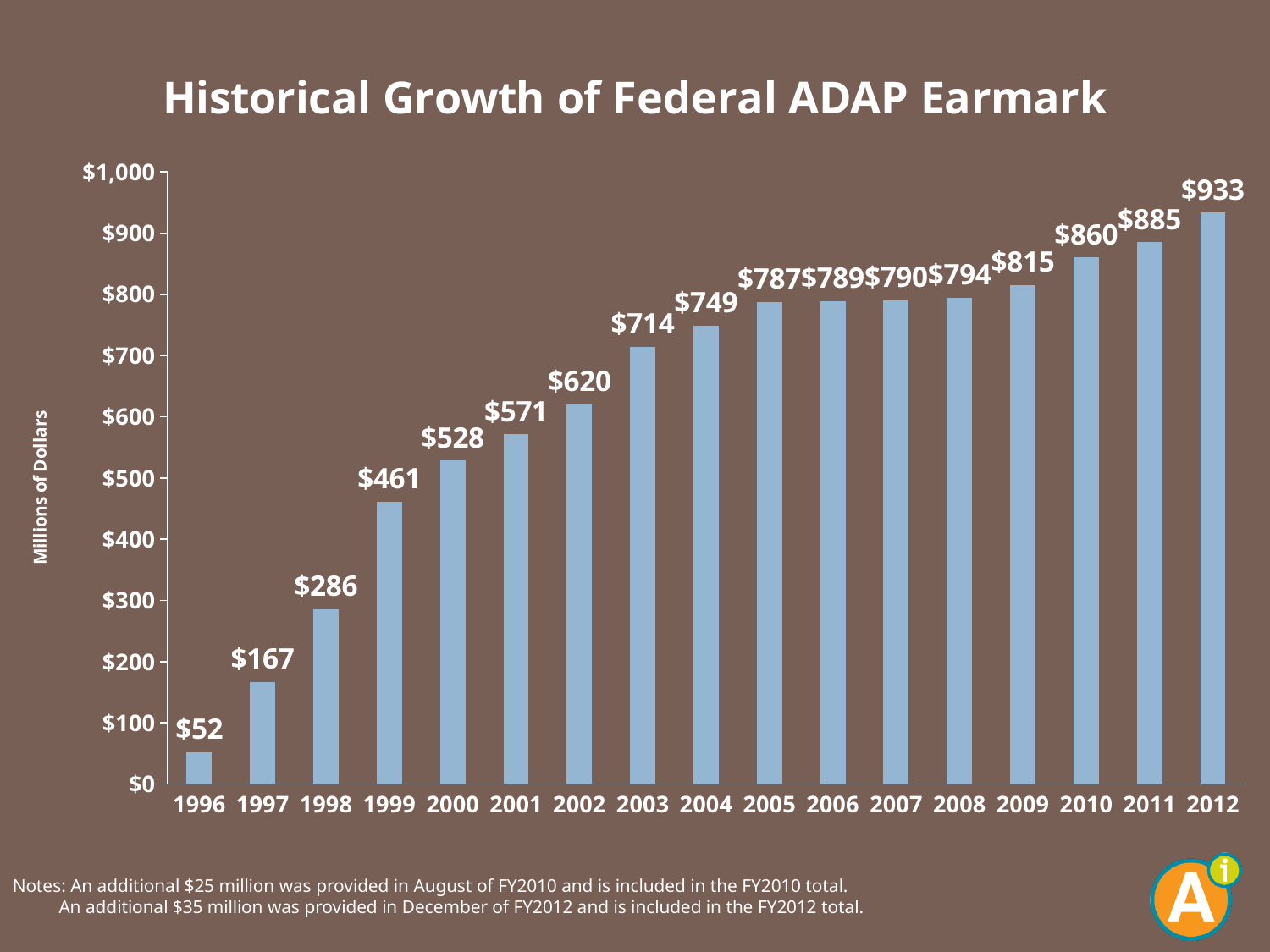
Which year has the highest value? 2012 How many years are shown on the x axis? 17 What is the difference between the values for 2012 and 2011? $48 What is the value for 1998? $286 What is the value for 2003? $714 What is the difference between the values for 2000 and 1999? $67 What is the title of the chart? Historical Growth of Federal ADAP Earmark What is the value for 2009? $815 Which year has the lowest value? 1996 What kind of chart is this? bar chart Do the values rise or fall from 1996 to 2012? rise Which is larger, the value for 2002 or the value for 2004? 2004